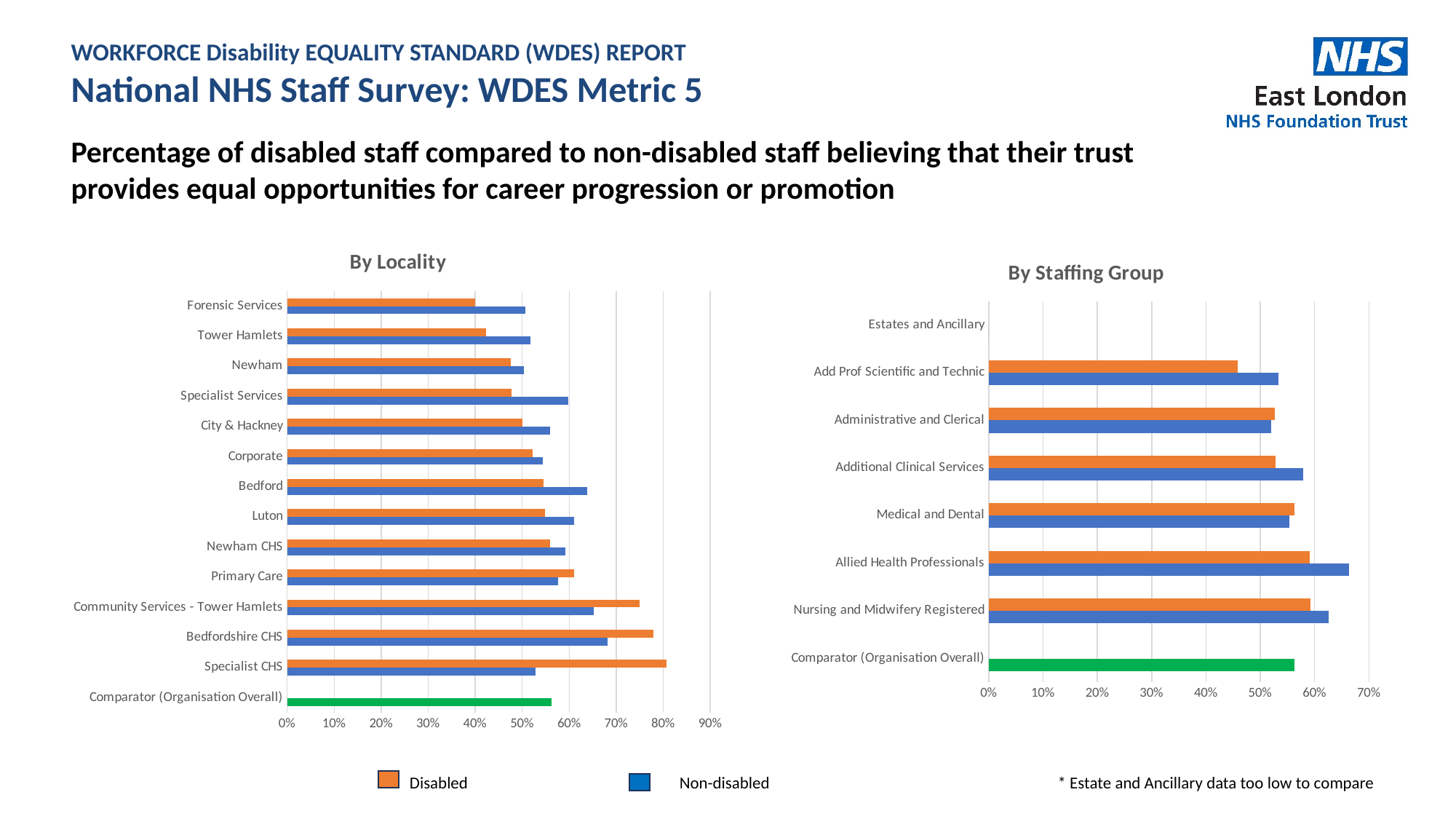
How many series does the legend at the bottom of the slide list? 2 In the 'By Staffing Group' chart, which staffing group has the highest Non-disabled value? Allied Health Professionals What kind of chart is the 'By Locality' chart? Bar chart In the 'By Locality' chart, is the Disabled value for Forensic Services greater or less than 50%? less In the 'By Staffing Group' chart, is the Non-disabled value for Allied Health Professionals greater or less than 60%? greater In the 'By Locality' chart, is the Disabled value for Bedfordshire CHS greater or less than 70%? greater In the 'By Locality' chart, for Bedford, which is larger: the Disabled value or the Non-disabled value? Non-disabled In the 'By Locality' chart, for Specialist CHS, which is larger: the Disabled value or the Non-disabled value? Disabled According to the footnote, why does Estates and Ancillary show no bars in the 'By Staffing Group' chart? Data too low to compare In the 'By Staffing Group' chart, which staffing group has the lowest Disabled value? Add Prof Scientific and Technic In the 'By Locality' chart, which locality has the highest Disabled value? Specialist CHS In the 'By Locality' chart, how many categories are shown on the vertical axis? 14